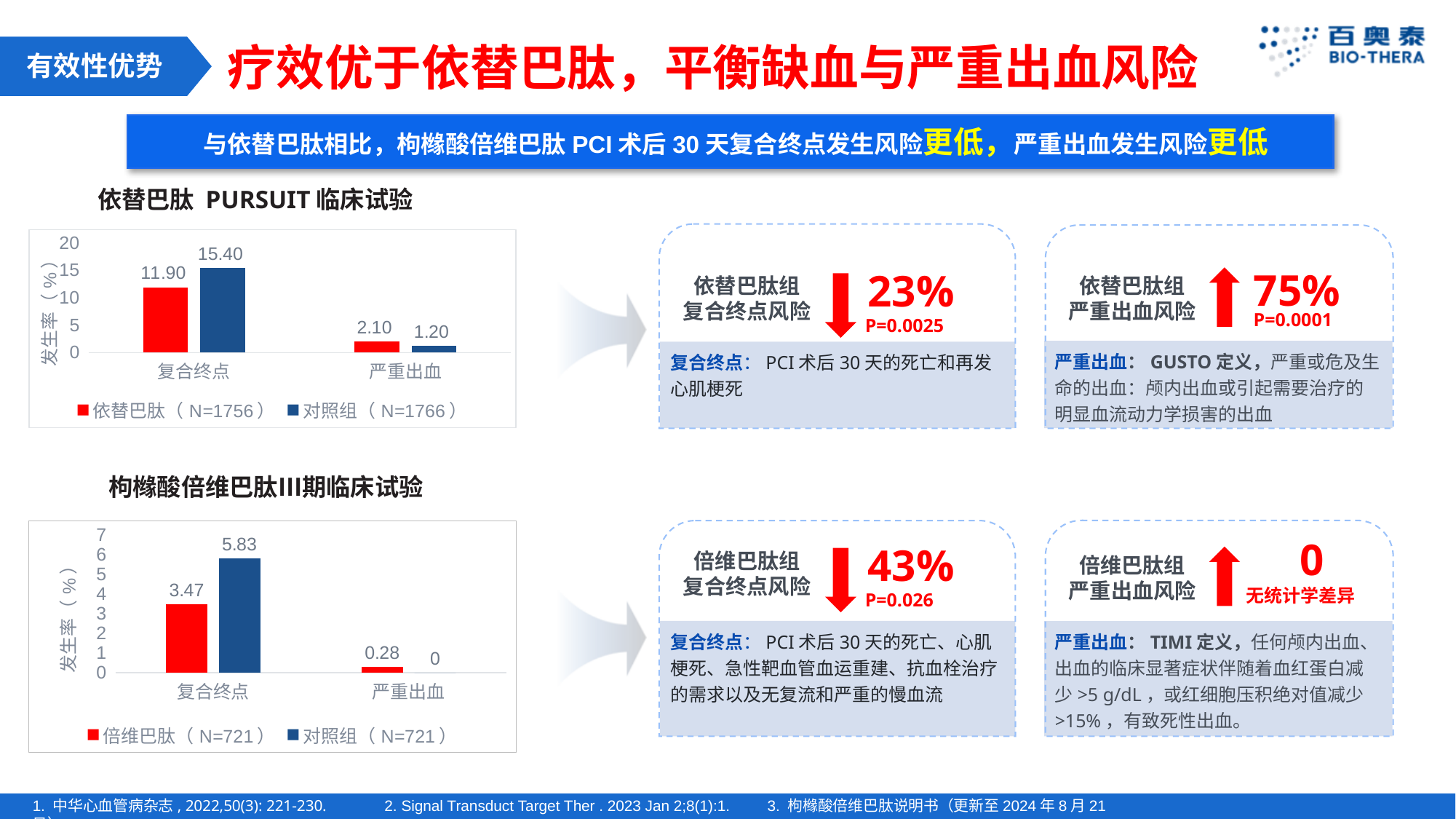
In the 依替巴肽 PURSUIT 临床试验 chart, what is the value for 对照组 at 严重出血? 1.20 In the 枸橼酸倍维巴肽III期临床试验 chart, what is the value for 对照组 at 复合终点? 5.83 In the 枸橼酸倍维巴肽III期临床试验 chart, which bar is the highest? 对照组 at 复合终点 In the 枸橼酸倍维巴肽III期临床试验 chart, what is the value for 对照组 at 严重出血? 0 In the 依替巴肽 PURSUIT 临床试验 chart, which series has the higher value at 严重出血? 依替巴肽（N=1756） In the 依替巴肽 PURSUIT 临床试验 chart, what is the difference between 对照组 and 依替巴肽 at 复合终点? 3.50 In the 枸橼酸倍维巴肽III期临床试验 chart, what is the sample size shown in the legend for 倍维巴肽? N=721 In the 依替巴肽 PURSUIT 临床试验 chart, what is the value for 依替巴肽 at 复合终点? 11.90 In the 枸橼酸倍维巴肽III期临床试验 chart, what is the value for 倍维巴肽 at 复合终点? 3.47 What kind of chart is the 枸橼酸倍维巴肽III期临床试验 chart? Bar chart In the 依替巴肽 PURSUIT 临床试验 chart, how many series does the legend list? 2 In the 枸橼酸倍维巴肽III期临床试验 chart, what is the difference between 对照组 and 倍维巴肽 at 复合终点? 2.36